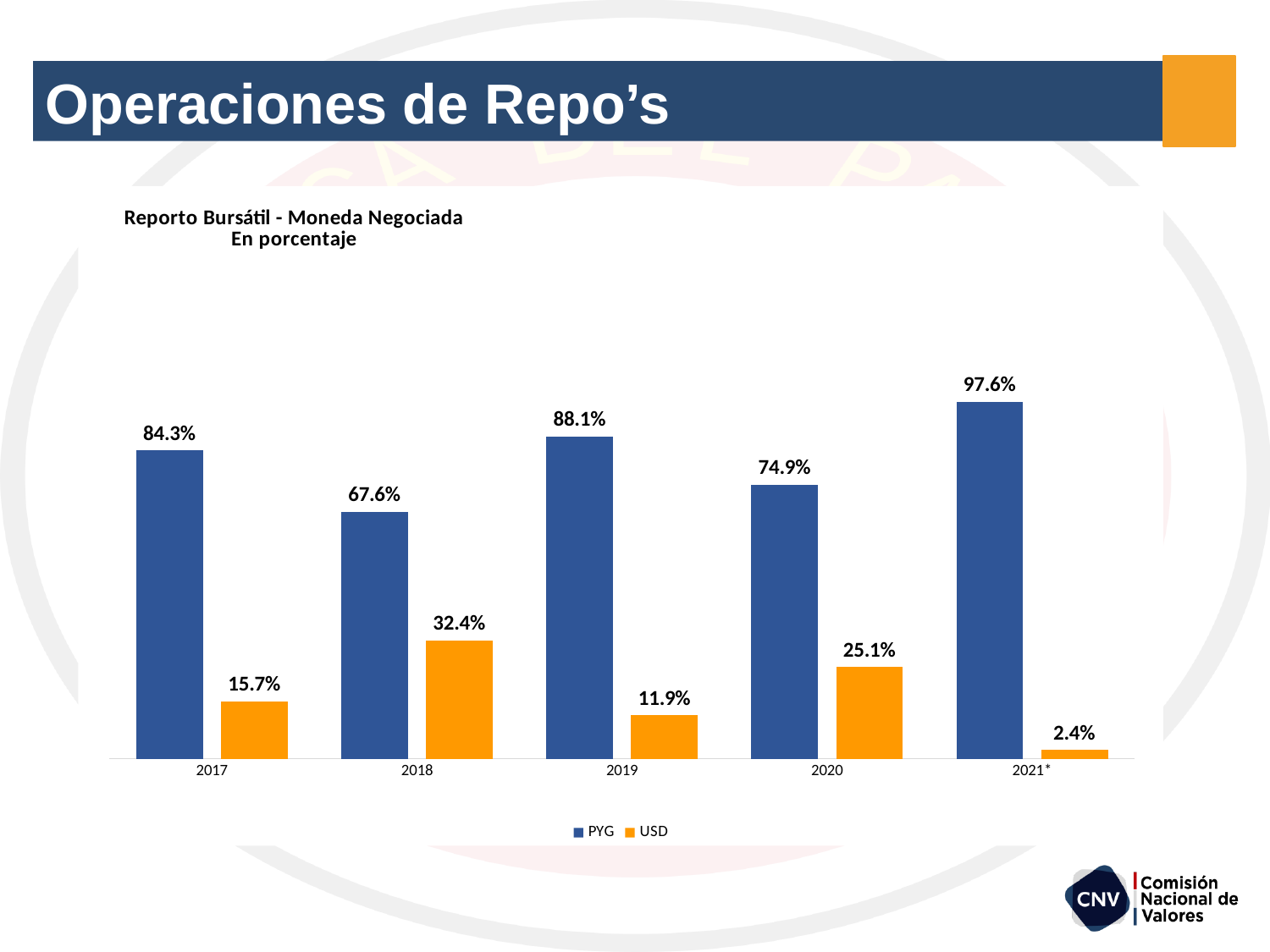
What is the title of the chart? Reporto Bursátil - Moneda Negociada En porcentaje How many years are shown on the x axis? 5 What kind of chart is shown on the slide? Bar chart Does the USD value rise or fall from 2020 to 2021*? Fall What is the USD value for 2021*? 2.4% Which is larger, the USD value for 2017 or the USD value for 2019? 2017 Which year has the lowest USD value? 2021* Which year has the highest PYG value? 2021* What is the PYG value for 2019? 88.1% What is the USD value for 2018? 32.4% What is the difference between the PYG and USD values in 2020? 49.8% How many series does the legend list? 2